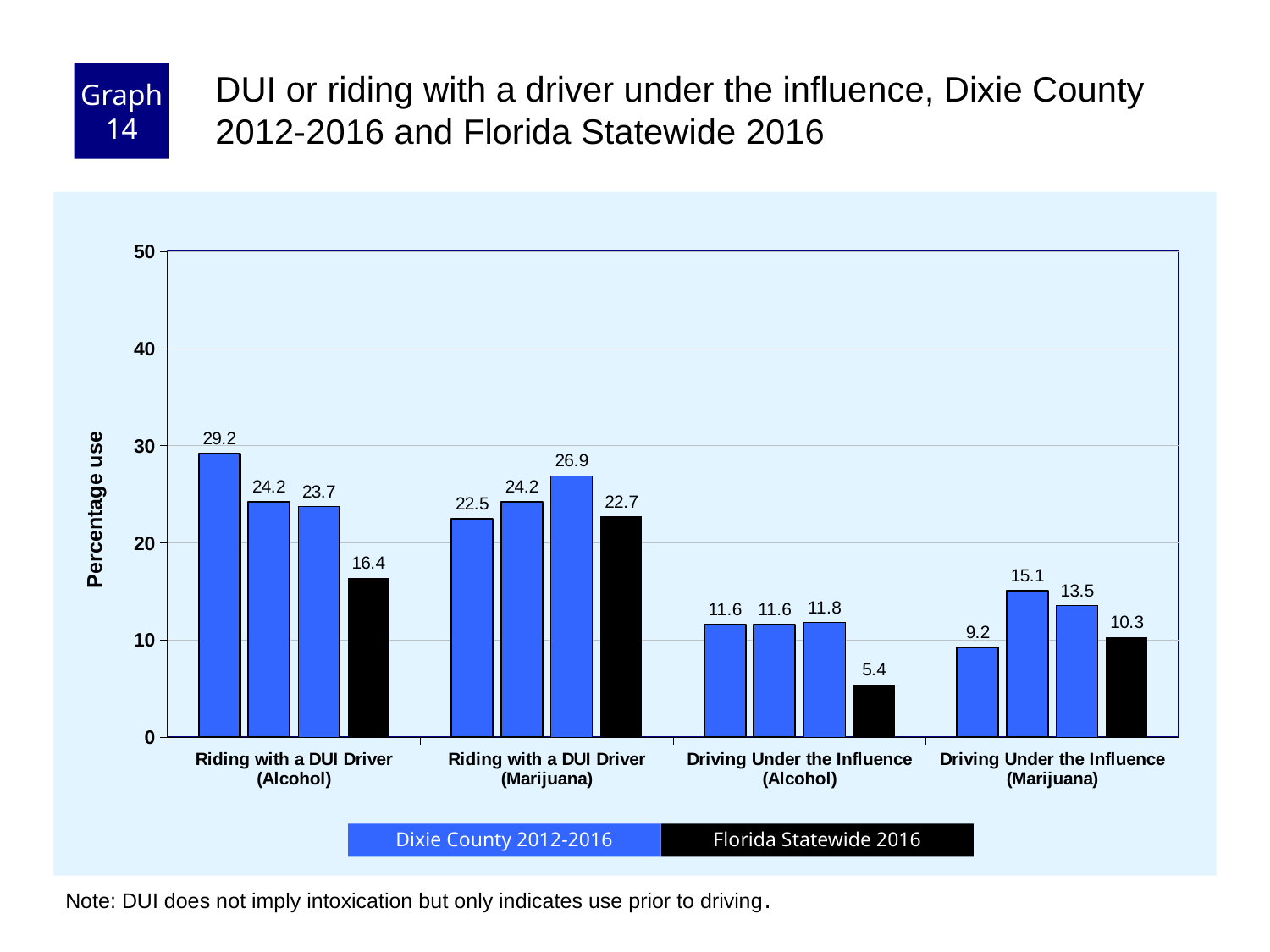
How many series does the legend list? 2 What kind of chart is shown on the slide? Bar chart How many categories are shown on the x axis? 4 What is the value of the leftmost Dixie County 2012-2016 bar for Riding with a DUI Driver (Alcohol)? 29.2 Which category has the lowest Florida Statewide 2016 value? Driving Under the Influence (Alcohol) What is the Florida Statewide 2016 value for Riding with a DUI Driver (Alcohol)? 16.4 What is the highest value shown for Riding with a DUI Driver (Marijuana)? 26.9 Which category has the highest Florida Statewide 2016 value? Riding with a DUI Driver (Marijuana) What is the Florida Statewide 2016 value for Driving Under the Influence (Marijuana)? 10.3 What is the difference between the Florida Statewide 2016 values for Riding with a DUI Driver (Alcohol) and Driving Under the Influence (Alcohol)? 11.0 Which is larger: the Florida Statewide 2016 value for Riding with a DUI Driver (Marijuana) or for Driving Under the Influence (Marijuana)? Riding with a DUI Driver (Marijuana) What is the Florida Statewide 2016 value for Driving Under the Influence (Alcohol)? 5.4